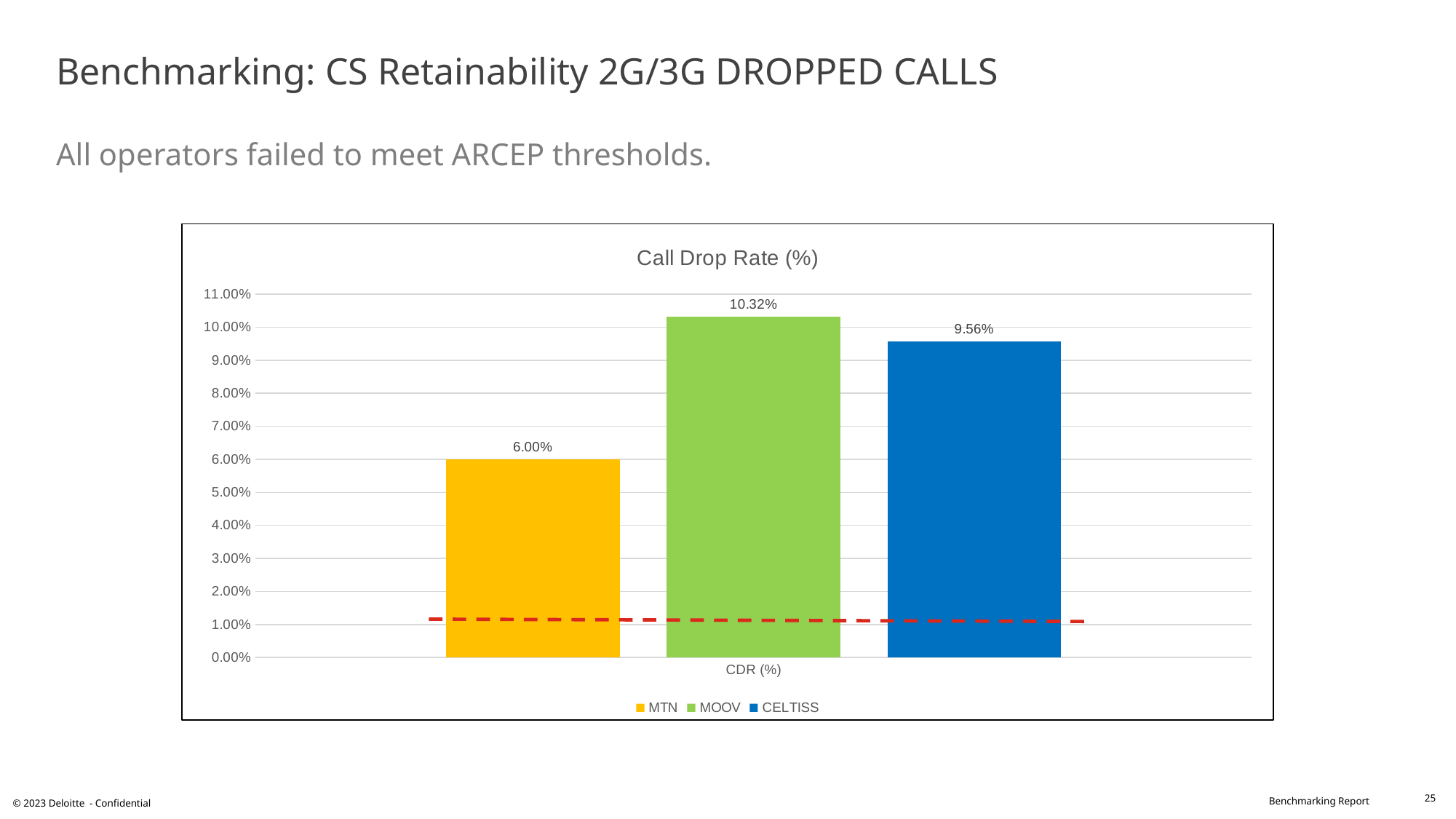
Which operator has the lowest call drop rate? MTN What is the call drop rate for MTN? 6.00% Is the call drop rate for CELTISS greater or less than 9.00%? greater What is the call drop rate for MOOV? 10.32% What is the difference between the call drop rates of MOOV and MTN? 4.32% How many series does the legend list? 3 Which has a higher call drop rate, CELTISS or MTN? CELTISS What is the call drop rate for CELTISS? 9.56% What is the title of the chart? Call Drop Rate (%) What kind of chart is shown on the slide? Bar chart What is the difference between the call drop rates of MOOV and CELTISS? 0.76% Which operator has the highest call drop rate? MOOV